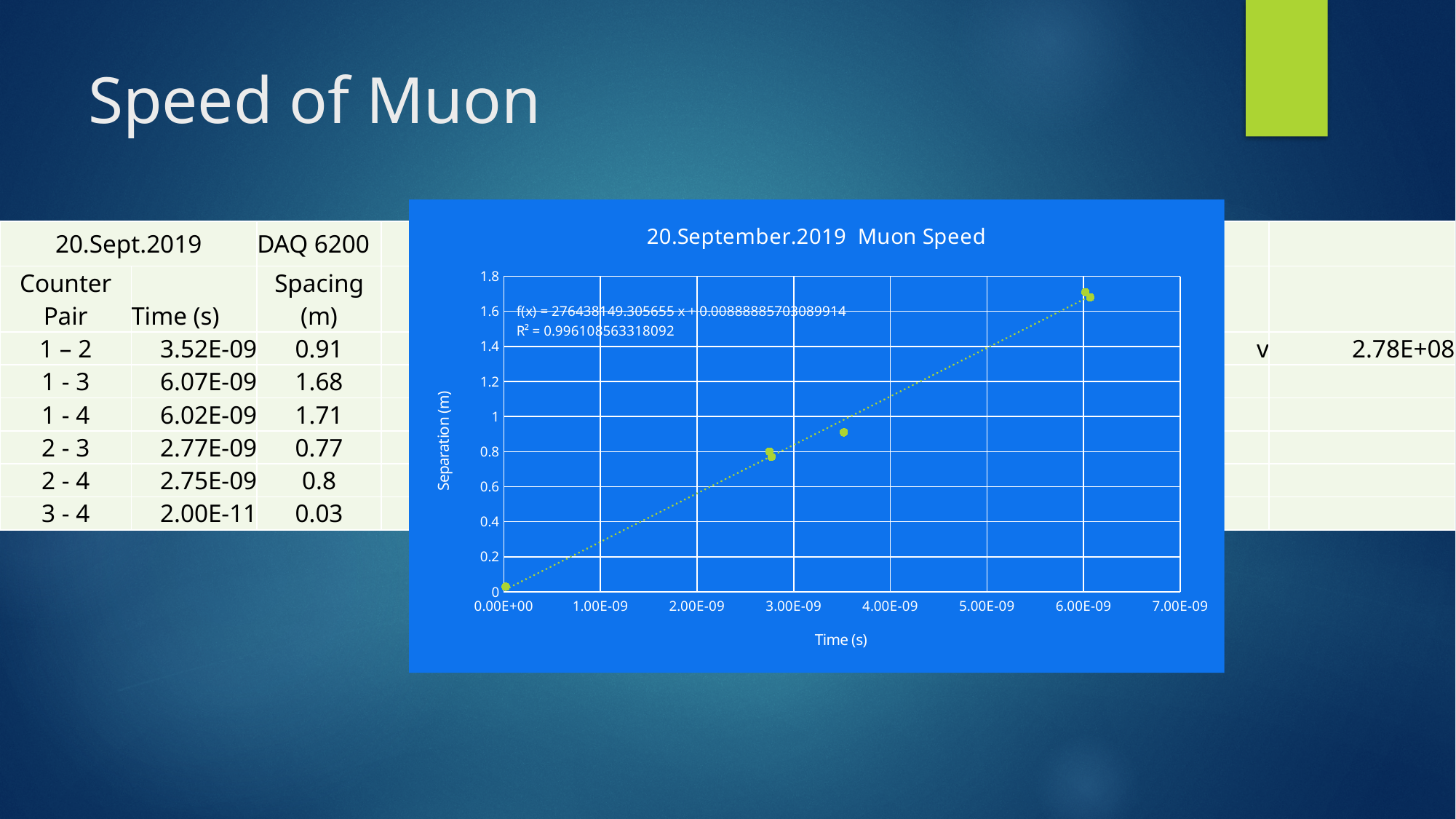
What is the title of the chart? 20.September.2019 Muon Speed What is the highest tick value shown on the chart's horizontal axis? 7.00E-09 What R² value is printed on the chart for the trendline? 0.996108563318092 Do the plotted separation values rise or fall as time increases along the x axis? rise How many data points are plotted in the chart? 6 Which has the larger separation: the point near 6.00E-09 s or the point near 3.5E-09 s? the point near 6.00E-09 s What is the highest tick value shown on the chart's vertical axis? 1.8 Is the separation value for the point near 0.00E+00 s greater or less than 0.2? less Is the separation value for the point at about 3.5E-09 s greater or less than 0.8? greater Are the separation values for the points near 6.00E-09 s greater or less than 1.6? greater What is the label of the chart's vertical axis? Separation (m) What kind of chart is shown on the slide? scatter chart